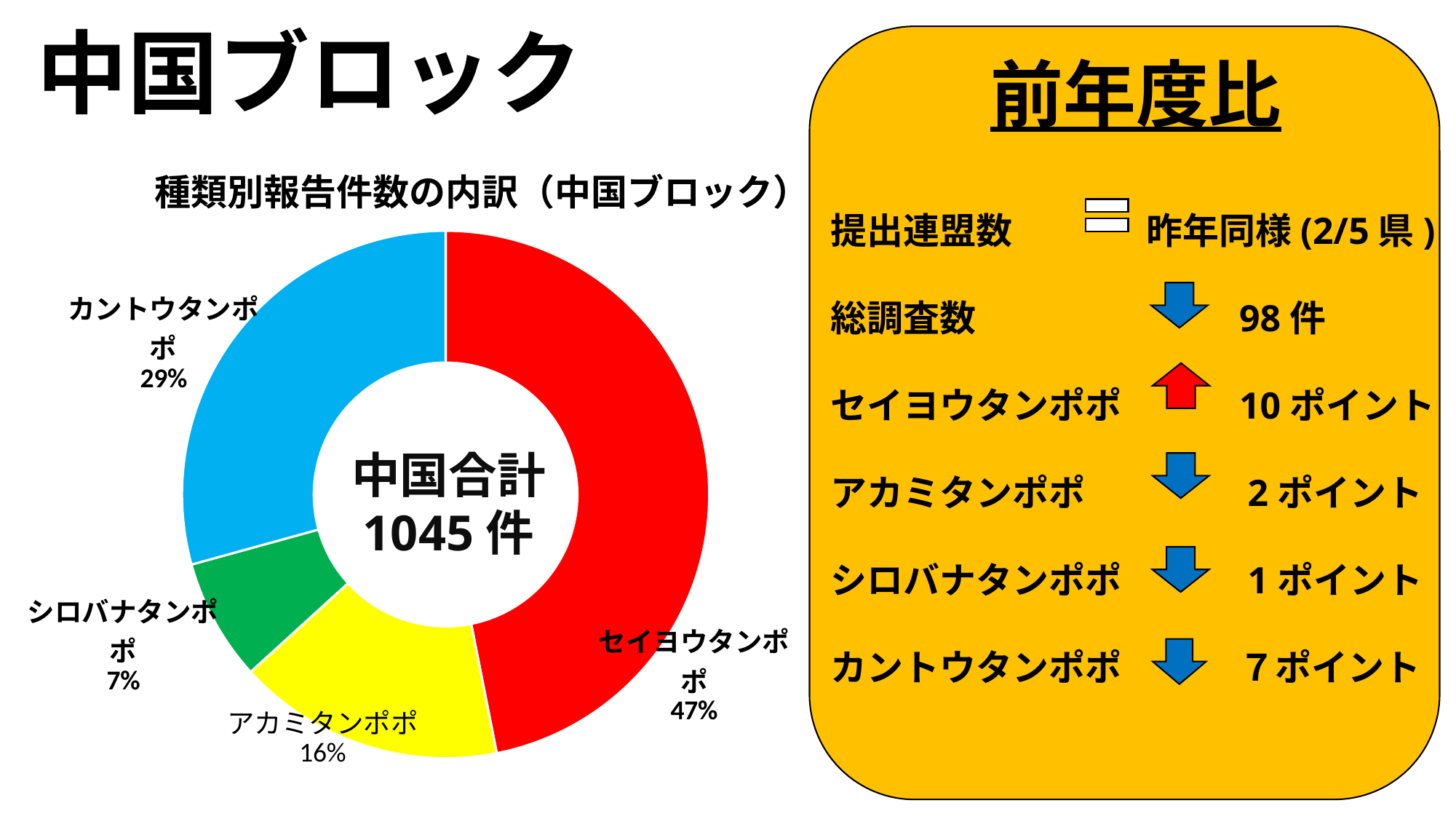
What share of the pie does シロバナタンポポ have? 7% What share of the pie does セイヨウタンポポ have? 47% What share of the pie does カントウタンポポ have? 29% What is the difference in percentage points between セイヨウタンポポ and カントウタンポポ? 18 Which category has the smallest share of the pie? シロバナタンポポ Which category has the largest share of the pie? セイヨウタンポポ Which has a larger share, アカミタンポポ or シロバナタンポポ? アカミタンポポ What total is printed in the centre of the chart? 中国合計 1045 件 What is the title of the chart? 種類別報告件数の内訳（中国ブロック） How many categories are shown in the pie chart? 4 What kind of chart is shown on the slide? Pie chart (doughnut)